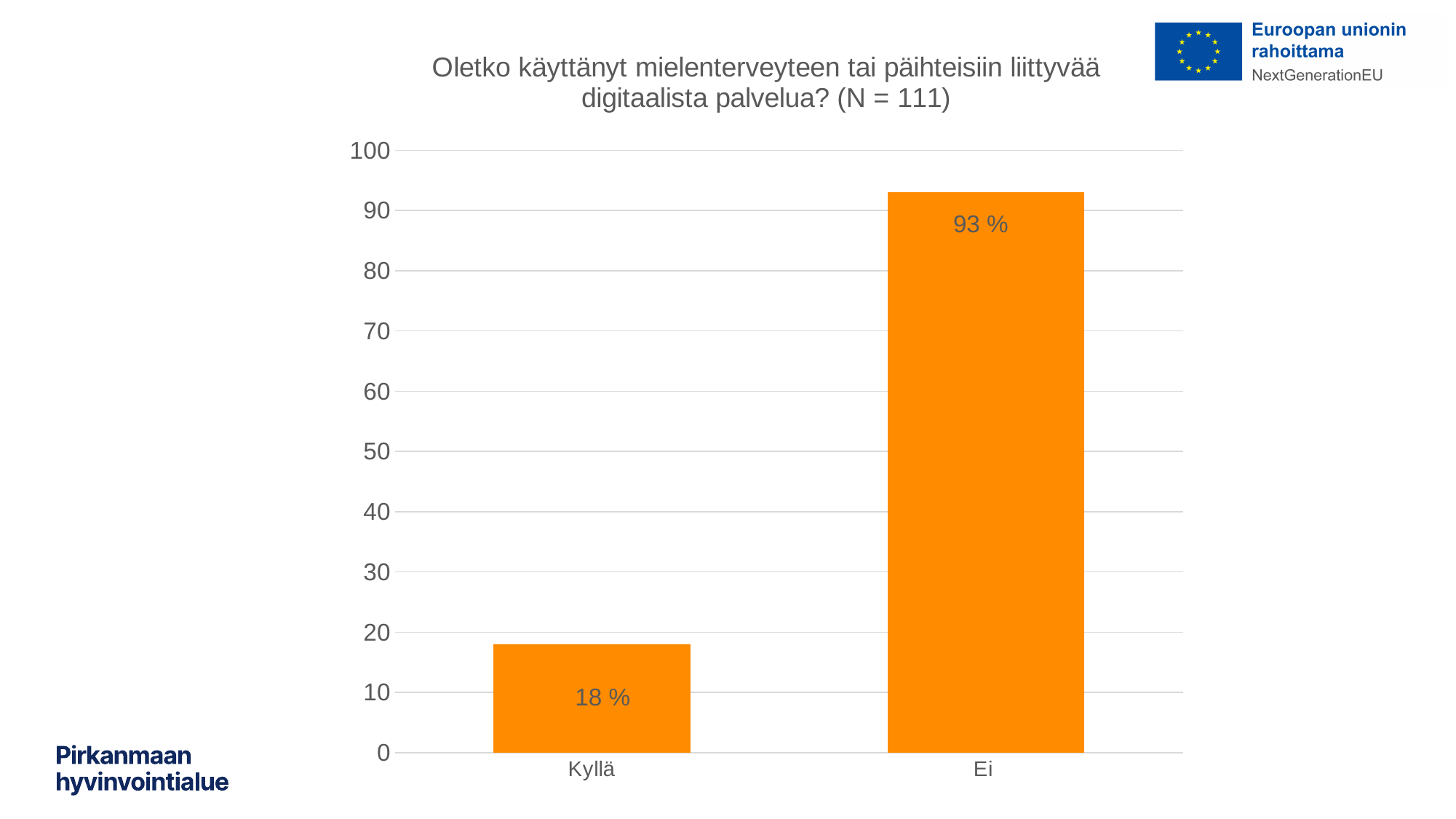
Is the value for Kyllä greater or less than 20? less Which category has the lowest value? Kyllä What is the value for Kyllä? 18 % What is the difference between the values for Ei and Kyllä? 75 % What is the value for Ei? 93 % Is the value for Ei greater or less than 90? greater Which category has the highest value? Ei What is the N value given in the chart title? 111 What colour are the bars in the chart? orange How many categories are shown on the x axis? 2 What kind of chart is shown on the slide? bar chart Which is larger, the value for Kyllä or the value for Ei? Ei